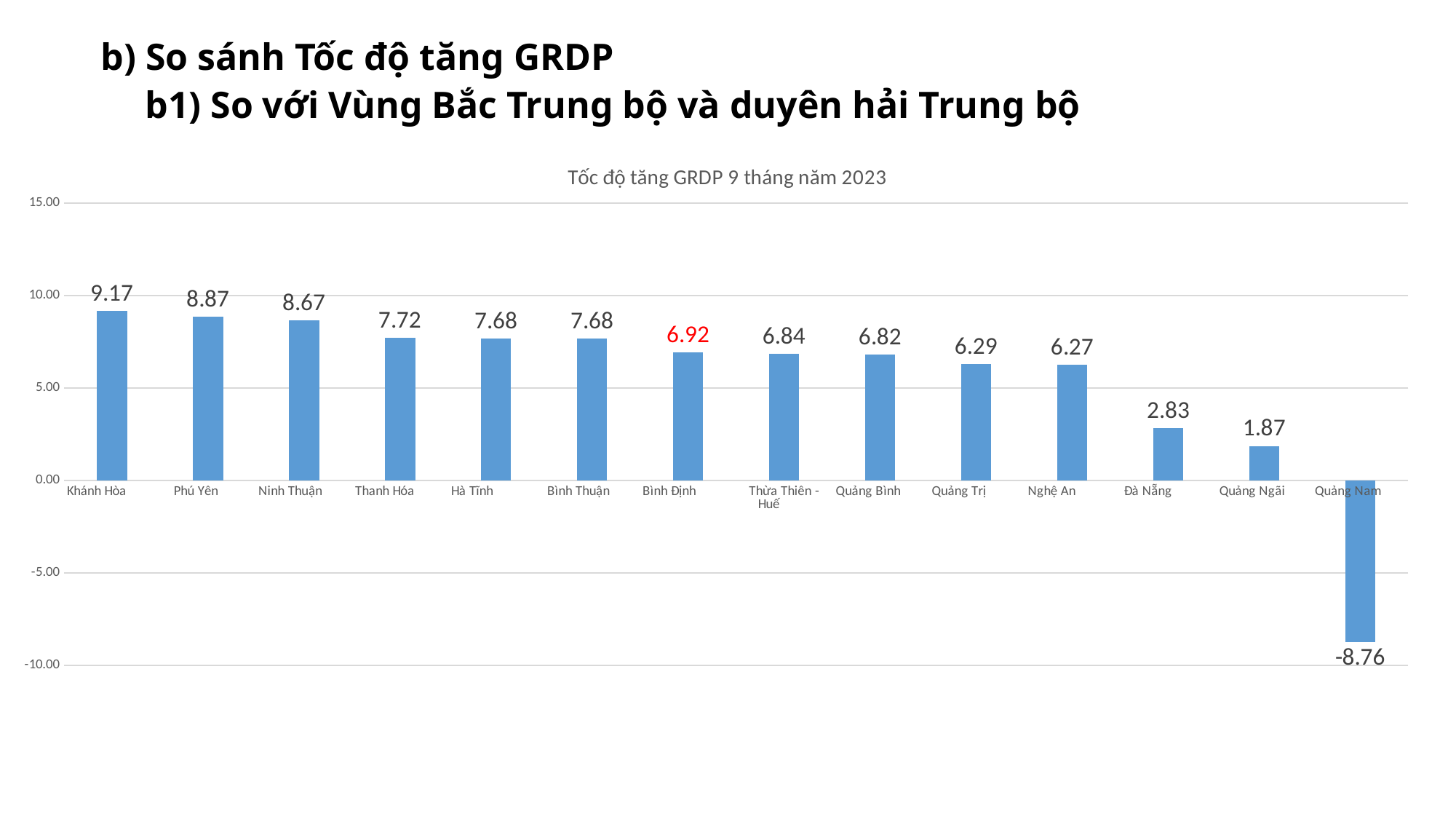
How many categories are shown on the x axis? 14 What is the value for Khánh Hòa? 9.17 Which is larger, the value for Quảng Trị or the value for Quảng Ngãi? Quảng Trị Which category has the lowest value? Quảng Nam Which category has the highest value? Khánh Hòa What is the value for Bình Định? 6.92 What kind of chart is shown? bar chart What is the difference between the values for Khánh Hòa and Phú Yên? 0.30 What is the value for Quảng Nam? -8.76 Is the value for Ninh Thuận greater or less than 5.00? greater What is the title of the chart? Tốc độ tăng GRDP 9 tháng năm 2023 What is the value for Đà Nẵng? 2.83